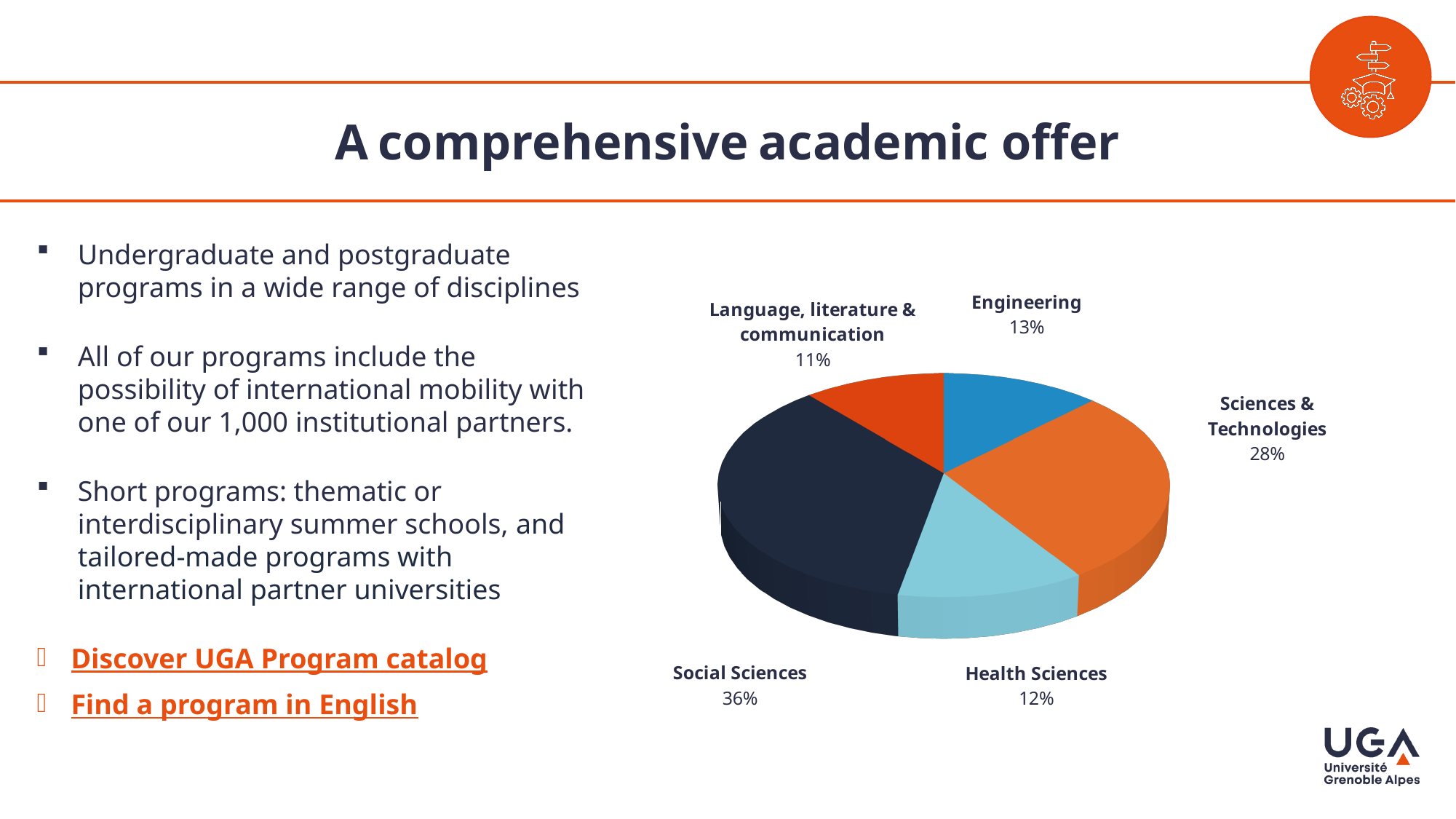
What percentage is shown for Engineering? 13% What colour is the Social Sciences slice? Dark navy blue What is the value for Language, literature & communication? 11% What is the value shown for Sciences & Technologies? 28% What percentage is shown for Health Sciences? 12% Which is larger, the share for Engineering or the share for Health Sciences? Engineering What share of the pie does Social Sciences represent? 36% What is the difference between the Social Sciences share and the Sciences & Technologies share? 8% Which category has the smallest share of the pie? Language, literature & communication What kind of chart is shown on the slide? Pie chart How many categories are shown in the pie chart? 5 Which category has the largest share of the pie? Social Sciences